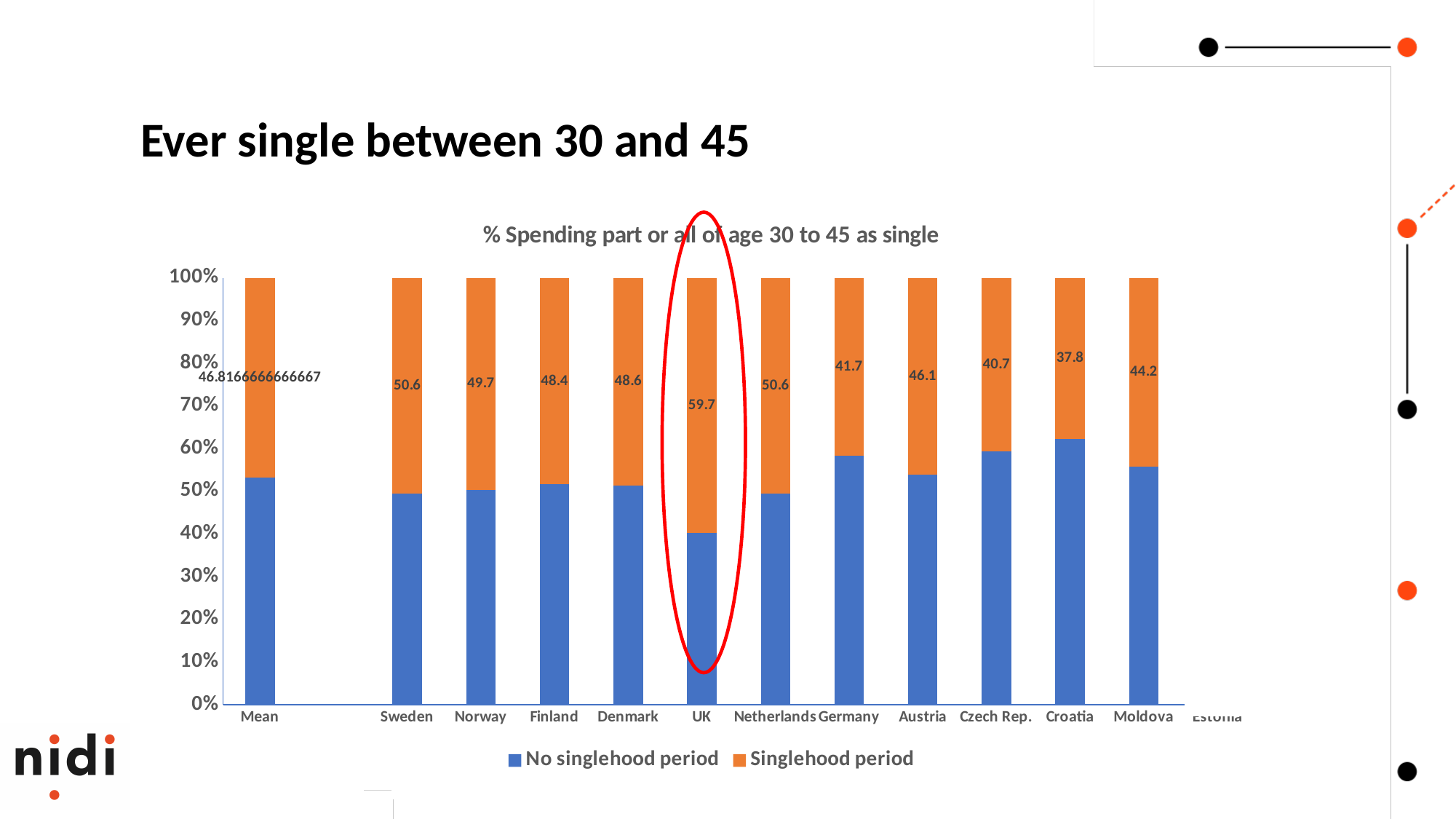
What is the Singlehood period value shown for Mean? 46.8166666666667 Which country has the highest Singlehood period value? UK What is the Singlehood period value for the UK? 59.7 What is the title of the chart? % Spending part or all of age 30 to 45 as single What is the difference between the Singlehood period values for the UK and Croatia? 21.9 What is the Singlehood period value for Croatia? 37.8 Which country has the lowest Singlehood period value? Croatia What kind of chart is shown on the slide? Stacked bar chart Which has a larger Singlehood period value, Sweden or Norway? Sweden Is the No singlehood period value for the UK greater or less than 50%? less How many series does the legend list? 2 What is the Singlehood period value for Germany? 41.7